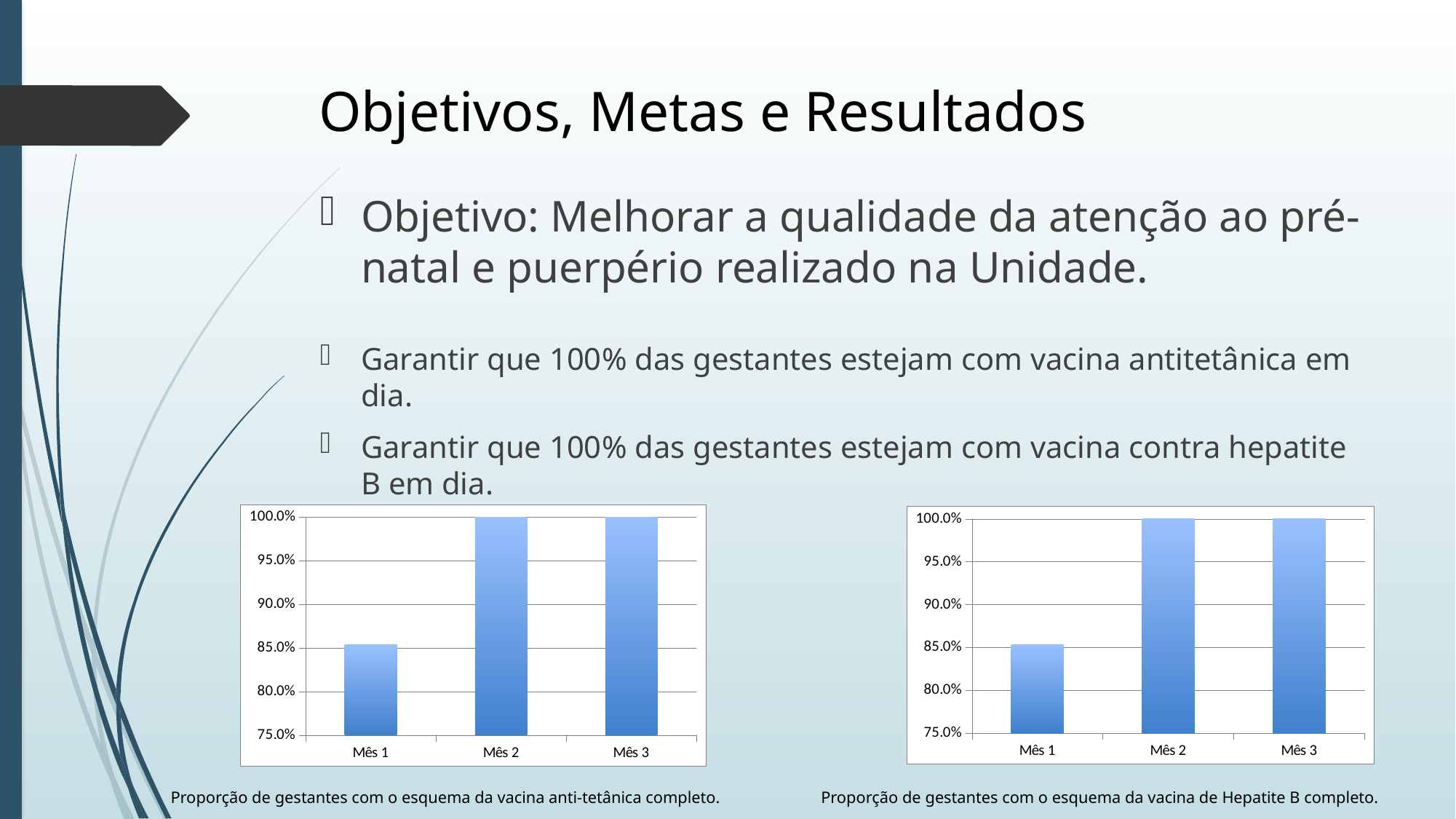
In the left chart (vacina anti-tetânica), which is larger, the value for Mês 1 or Mês 2? Mês 2 In the right chart (vacina de Hepatite B), which month has the lowest value? Mês 1 What is the lowest value shown on the y axis of the right chart (vacina de Hepatite B)? 75.0% In the left chart (vacina anti-tetânica), what is the value for Mês 2? 100.0% What is the caption below the left chart? Proporção de gestantes com o esquema da vacina anti-tetânica completo. What kind of chart is the left chart (vacina anti-tetânica)? bar chart In the right chart (vacina de Hepatite B), do the values rise or fall from Mês 1 to Mês 2? rise In the right chart (vacina de Hepatite B), is the value for Mês 1 greater or less than 80.0%? greater How many categories are shown on the x axis of the right chart (vacina de Hepatite B)? 3 In the left chart (vacina anti-tetânica), is the value for Mês 1 greater or less than 90.0%? less In the right chart (vacina de Hepatite B), what is the value for Mês 3? 100.0% In the left chart (vacina anti-tetânica), which month has the lowest value? Mês 1